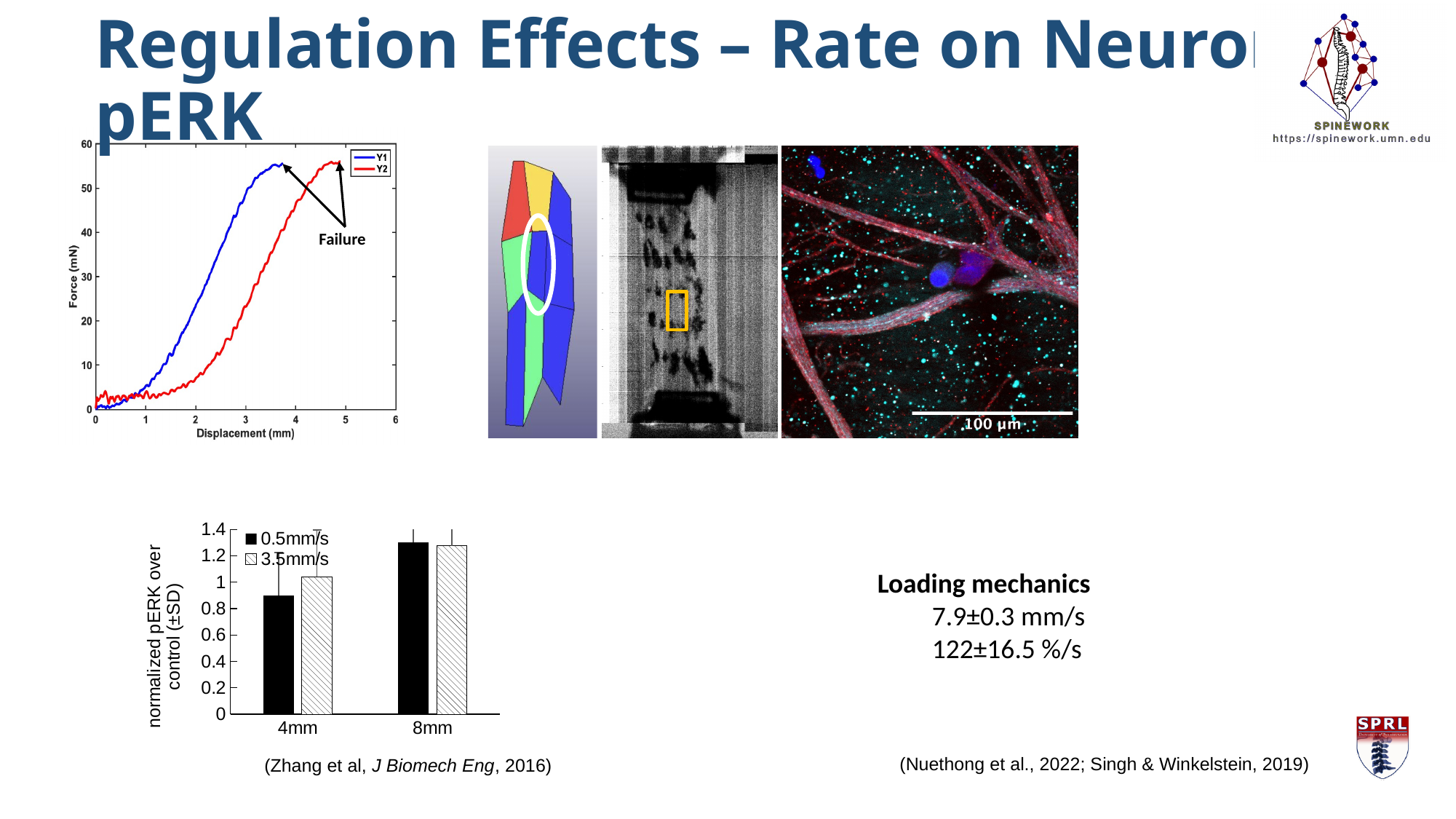
In the bottom-left pERK bar chart, at 4mm, which series has the larger value: 0.5mm/s or 3.5mm/s? 3.5mm/s What are the two series named in the legend of the bottom-left pERK bar chart? 0.5mm/s and 3.5mm/s In the bottom-left pERK bar chart, is the value for 0.5mm/s at 4mm greater or less than 1? less In the top-left Force versus Displacement chart, is the force for Y2 at a displacement of 2 mm greater or less than 10 mN? less What kind of chart is the bottom-left chart showing normalized pERK over control? bar chart In the bottom-left pERK bar chart, is the value for 3.5mm/s at 4mm greater or less than 0.8? greater In the bottom-left pERK bar chart, for the 0.5mm/s series, which category has the higher value? 8mm What kind of chart is the top-left chart of Force versus Displacement? line chart How many displacement categories are shown on the x axis of the bottom-left pERK bar chart? 2 How many series does the legend of the bottom-left pERK bar chart list? 2 How many series does the legend of the top-left Force versus Displacement chart list? 2